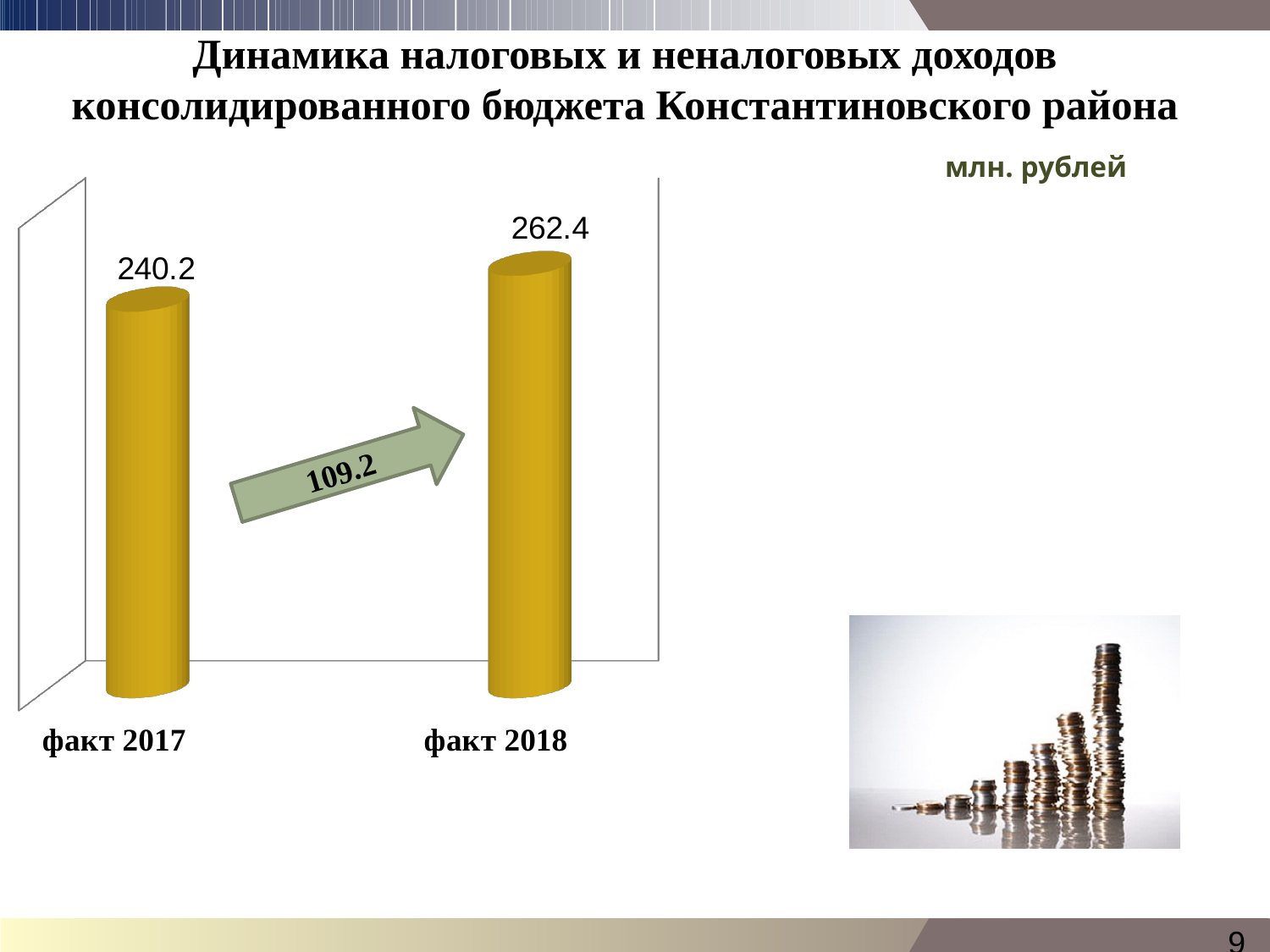
What unit of measurement is indicated on the slide for the chart values? млн. рублей What number is written on the arrow between the two bars? 109.2 What is the value for факт 2017? 240.2 Which category has the lowest value? факт 2017 Which is larger, the value for факт 2017 or факт 2018? факт 2018 What kind of chart is shown on the slide? bar chart Do the values rise or fall from факт 2017 to факт 2018? rise What is the value for факт 2018? 262.4 Which category has the highest value? факт 2018 How many categories are shown in the chart? 2 What is the difference between the values for факт 2018 and факт 2017? 22.2